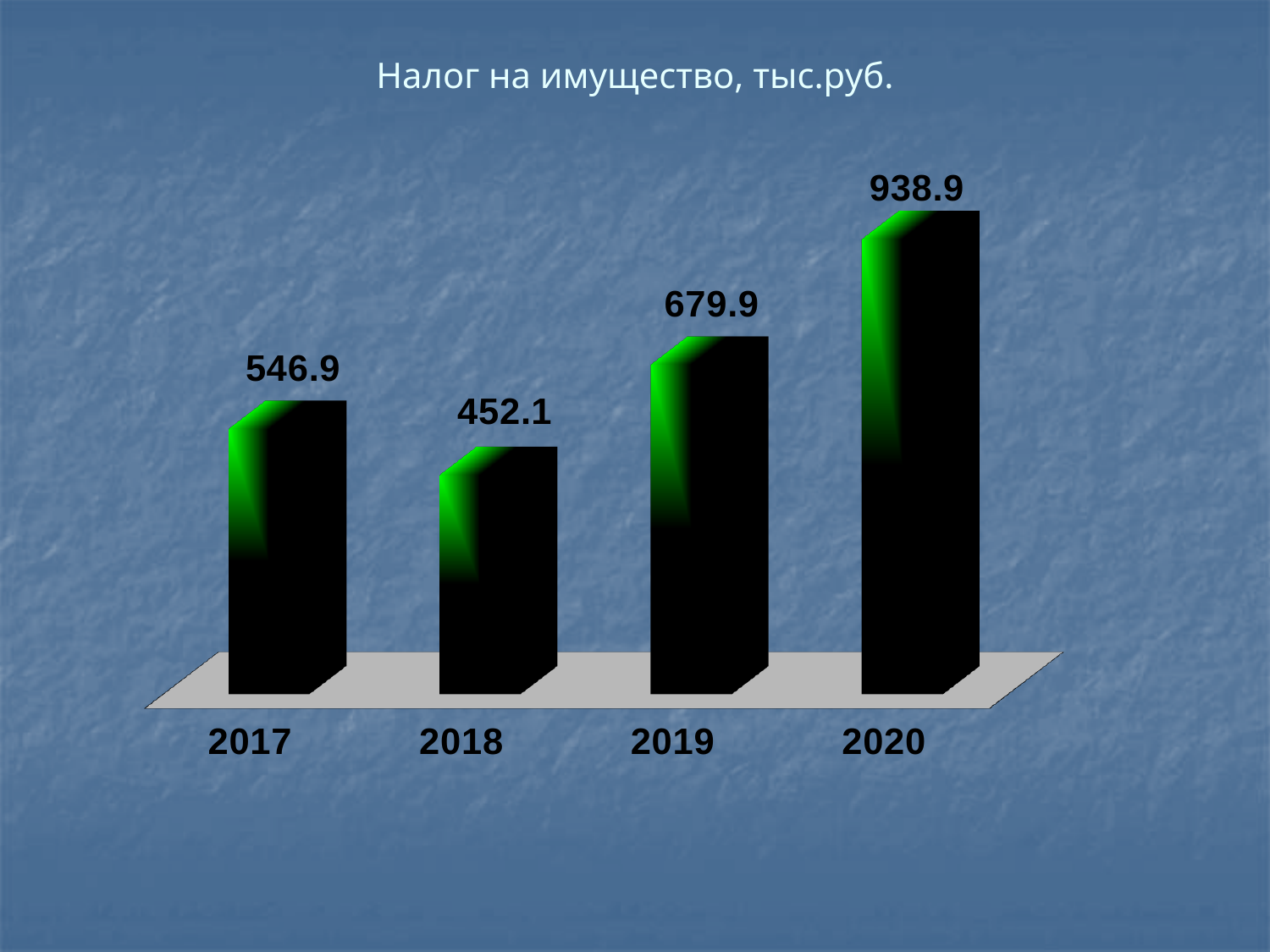
What is the value for 2019? 679.9 What is the value for 2018? 452.1 What kind of chart is this? bar chart Which year has the lowest value? 2018 Which year has the highest value? 2020 What is the title of the chart? Налог на имущество, тыс.руб. Which is larger, the value for 2017 or the value for 2019? 2019 What is the difference between the values for 2017 and 2018? 94.8 What is the difference between the values for 2020 and 2019? 259.0 How many years are shown on the chart? 4 What is the value for 2017? 546.9 What is the value for 2020? 938.9